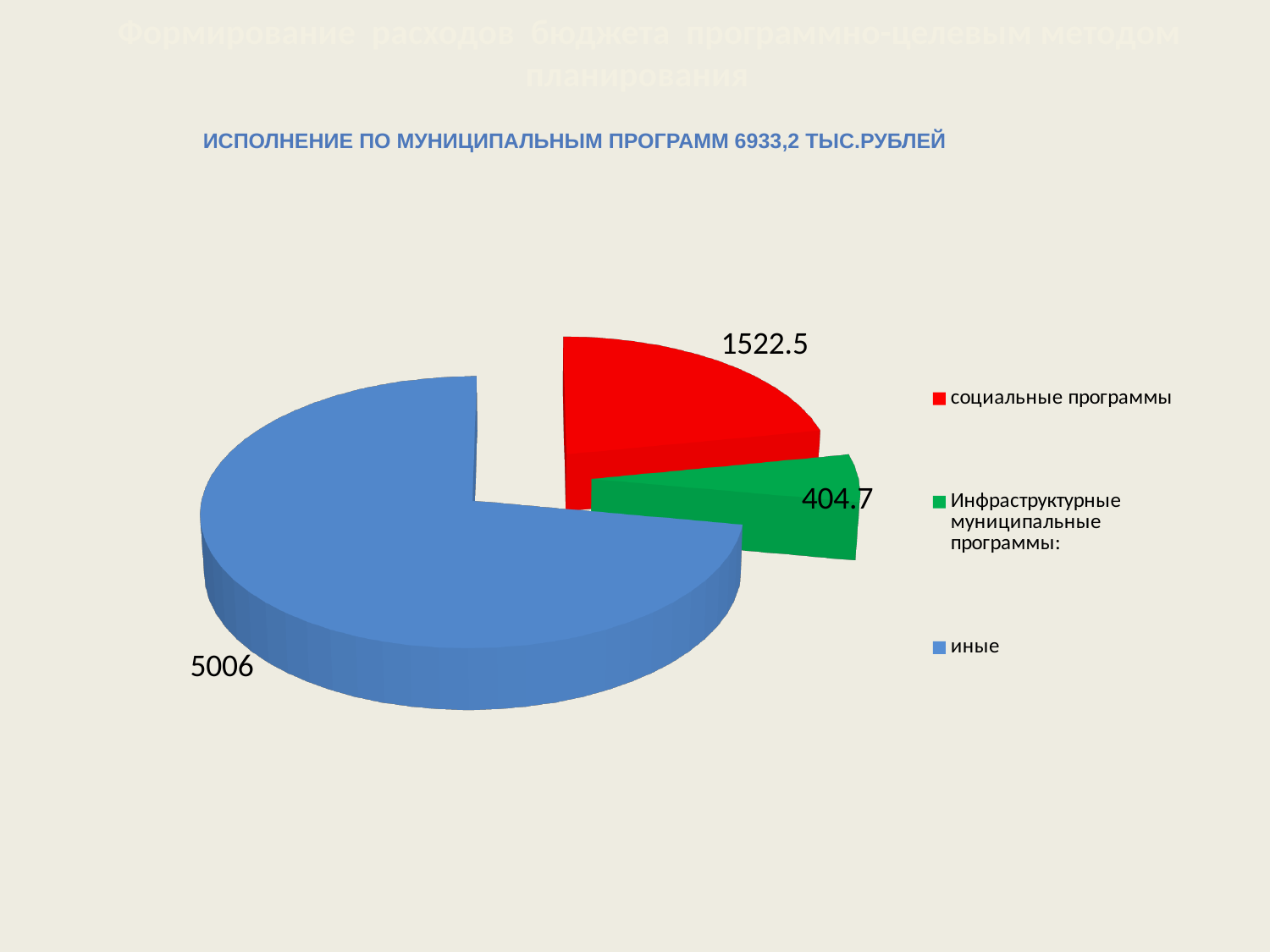
What is the value for иные? 5006 What is the difference between the values for социальные программы and Инфраструктурные муниципальные программы? 1117.8 How many slices does the pie chart have? 3 What type of chart is shown on the slide? pie chart What is the total of all slices in the pie chart? 6933.2 Which is larger, the value for социальные программы or the value for Инфраструктурные муниципальные программы? социальные программы What colour is the slice for иные? blue What is the difference between the values for иные and социальные программы? 3483.5 Which category has the smallest slice of the pie? Инфраструктурные муниципальные программы What is the value for социальные программы? 1522.5 What is the value for Инфраструктурные муниципальные программы? 404.7 Which category has the largest slice of the pie? иные